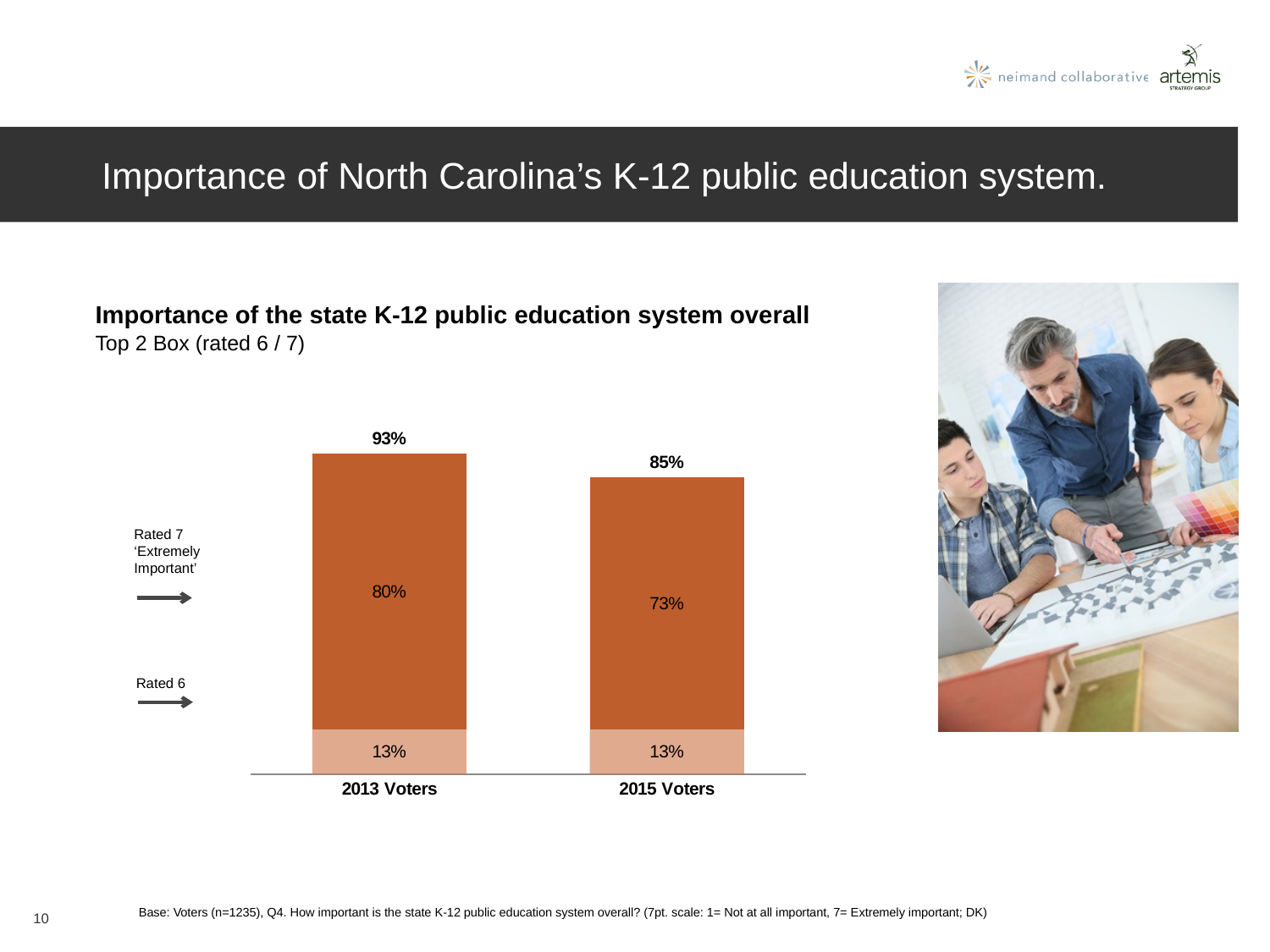
What kind of chart is shown on the slide? Stacked bar chart What percentage of 2015 Voters rated the state K-12 public education system 7 'Extremely Important'? 73% What percentage of 2015 Voters rated the system 6? 13% Which group has the higher Top 2 Box total, 2013 Voters or 2015 Voters? 2013 Voters What is the difference between the Top 2 Box totals for 2013 Voters and 2015 Voters? 8 percentage points What is the Top 2 Box total for 2015 Voters? 85% By how many percentage points did the 'Rated 7' share fall from 2013 Voters to 2015 Voters? 7 percentage points What percentage of 2013 Voters rated the state K-12 public education system 7 'Extremely Important'? 80% Does the Top 2 Box total rise or fall from 2013 Voters to 2015 Voters? Fall How many voter groups are shown on the chart? 2 What is the title of the chart? Importance of the state K-12 public education system overall What is the Top 2 Box total for 2013 Voters? 93%